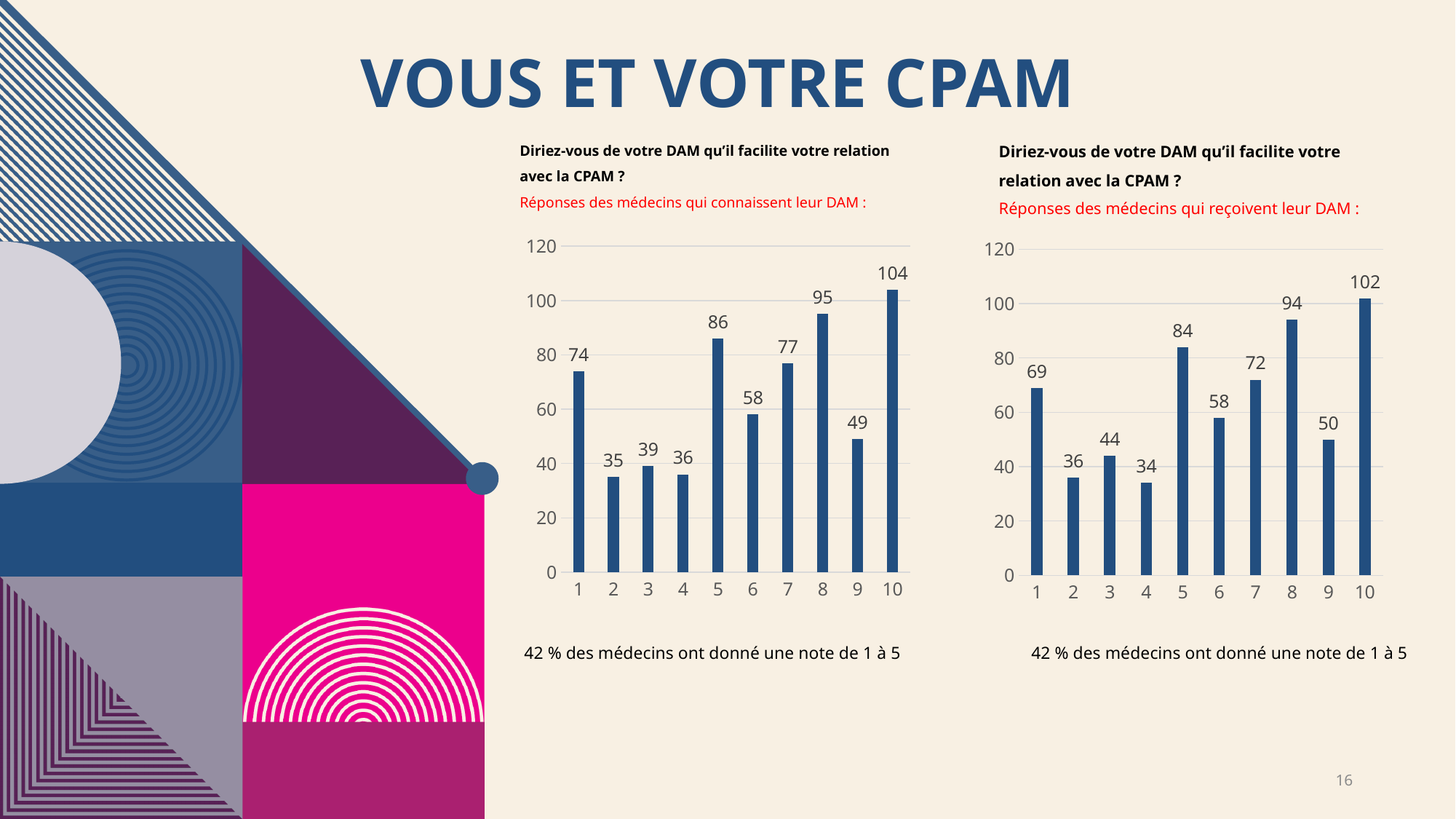
What is the maximum value shown on the y axis of the right chart (médecins qui reçoivent leur DAM)? 120 In the left chart (médecins qui connaissent leur DAM), what is the value for rating 5? 86 In the left chart (médecins qui connaissent leur DAM), which rating has the highest value? 10 In the right chart (médecins qui reçoivent leur DAM), which is larger, the value for rating 1 or the value for rating 6? Rating 1 In the left chart (médecins qui connaissent leur DAM), is the value for rating 8 greater or less than 80? greater In the right chart (médecins qui reçoivent leur DAM), what is the value for rating 7? 72 How many rating categories are shown on the x axis of the right chart (médecins qui reçoivent leur DAM)? 10 In the left chart (médecins qui connaissent leur DAM), what is the lowest value shown? 35 In the right chart (médecins qui reçoivent leur DAM), what is the difference between the values for rating 5 and rating 4? 50 What kind of chart is the left chart (médecins qui connaissent leur DAM)? Bar chart In the left chart (médecins qui connaissent leur DAM), what is the difference between the values for rating 10 and rating 9? 55 In the right chart (médecins qui reçoivent leur DAM), which rating has the lowest value? 4